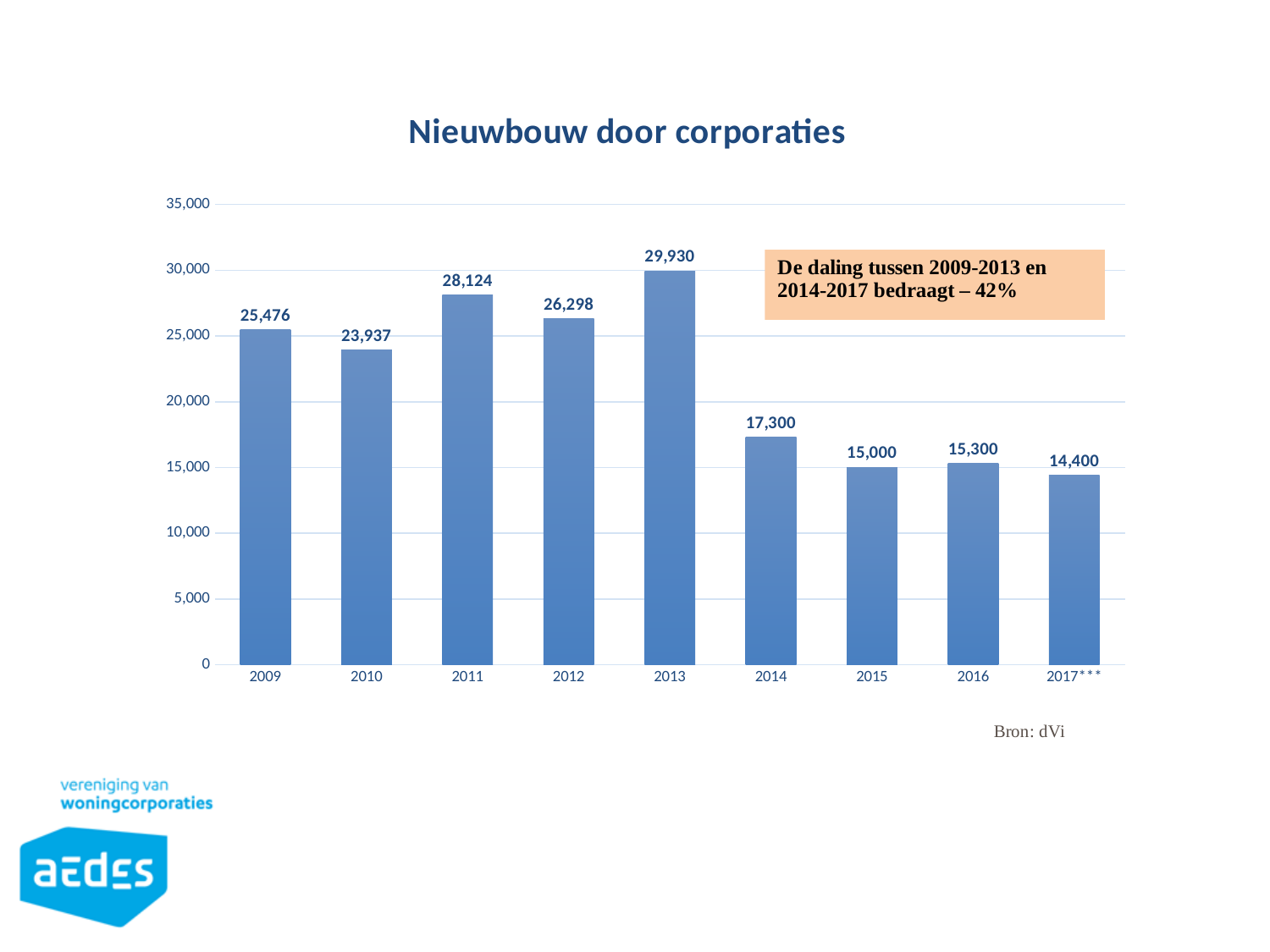
What is the title of the chart? Nieuwbouw door corporaties Which is larger, the value for 2011 or the value for 2012? 2011 How many years are shown on the x axis? 9 Is the value for 2015 greater or less than 20,000? less What is the difference between the values for 2013 and 2014? 12,630 Do the values rise or fall from 2013 to 2014? fall Which year has the highest value? 2013 What is the value for 2017***? 14,400 What kind of chart is this? bar chart What is the value for 2013? 29,930 What is the value for 2010? 23,937 Which year has the lowest value? 2017***